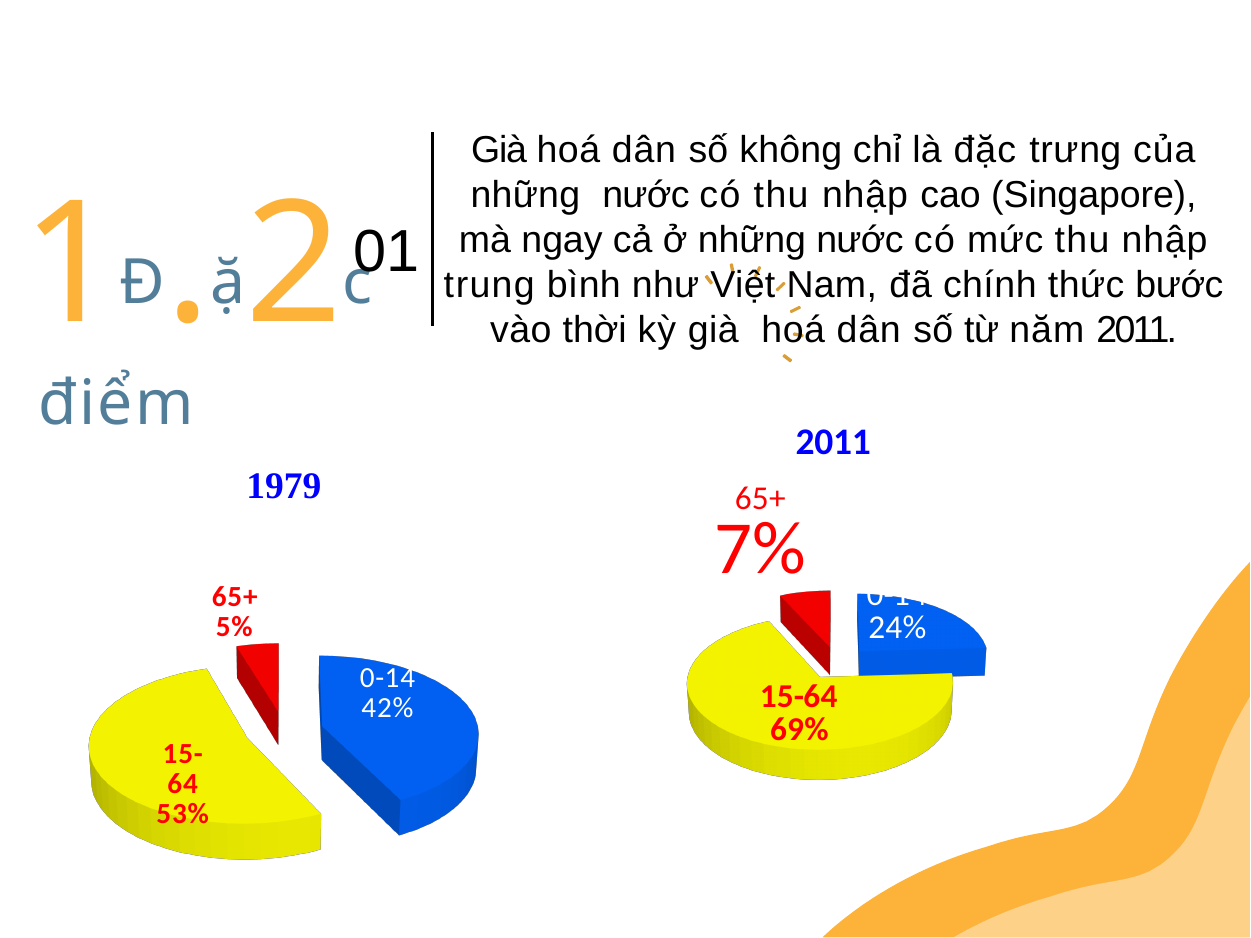
In the 1979 pie chart, which age group has the smallest share? 65+ In the 2011 pie chart, what share is the 0-14 age group? 24% In the 2011 pie chart, what share is the 65+ age group? 7% In the 1979 pie chart, what share is the 15-64 age group? 53% In the 1979 pie chart, what share is the 0-14 age group? 42% What type of chart is used to show the 2011 age distribution? Pie chart What is the difference between the 65+ share in 2011 and the 65+ share in 1979? 2% In the 2011 pie chart, which age group has the largest share? 15-64 In the 2011 pie chart, what share is the 15-64 age group? 69% How many slices does the 1979 pie chart have? 3 In the 1979 pie chart, what share is the 65+ age group? 5% Which is larger: the 0-14 share in 1979 or the 0-14 share in 2011? 1979